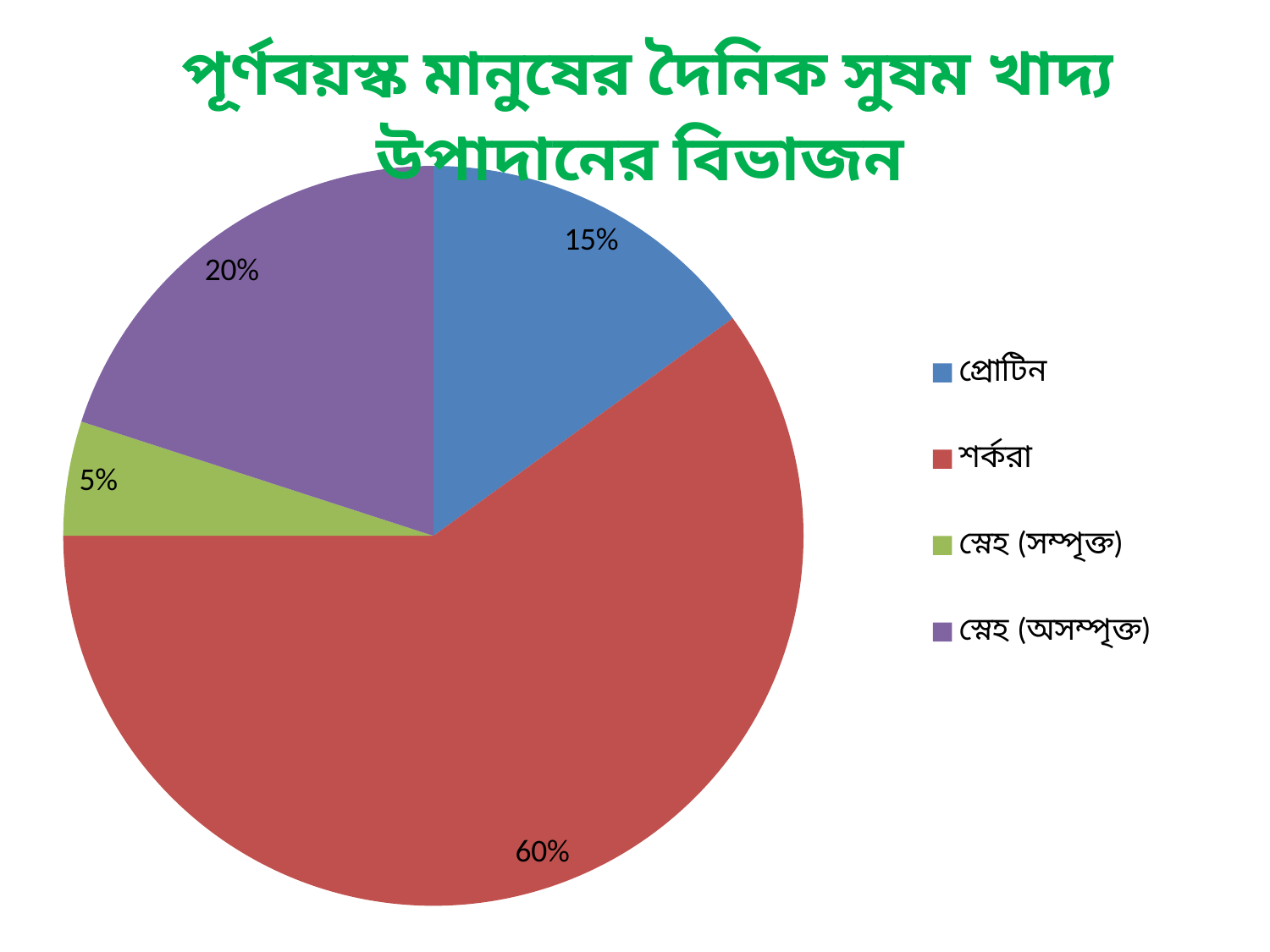
What colour is the slice for শর্করা? Red What percentage of the pie is labelled for স্নেহ (সম্পৃক্ত)? 5% How many categories does the pie chart have? 4 What kind of chart is shown on the slide? Pie chart Which is larger, the slice for স্নেহ (অসম্পৃক্ত) or the slice for প্রোটিন? স্নেহ (অসম্পৃক্ত) What percentage of the pie is labelled for স্নেহ (অসম্পৃক্ত)? 20% What percentage of the pie is labelled for শর্করা? 60% What is the combined share of the two স্নেহ slices (সম্পৃক্ত and অসম্পৃক্ত)? 25% Which category has the smallest slice of the pie? স্নেহ (সম্পৃক্ত) What percentage of the pie is labelled for প্রোটিন? 15% What is the difference in percentage points between শর্করা and প্রোটিন? 45 Which category has the largest slice of the pie? শর্করা